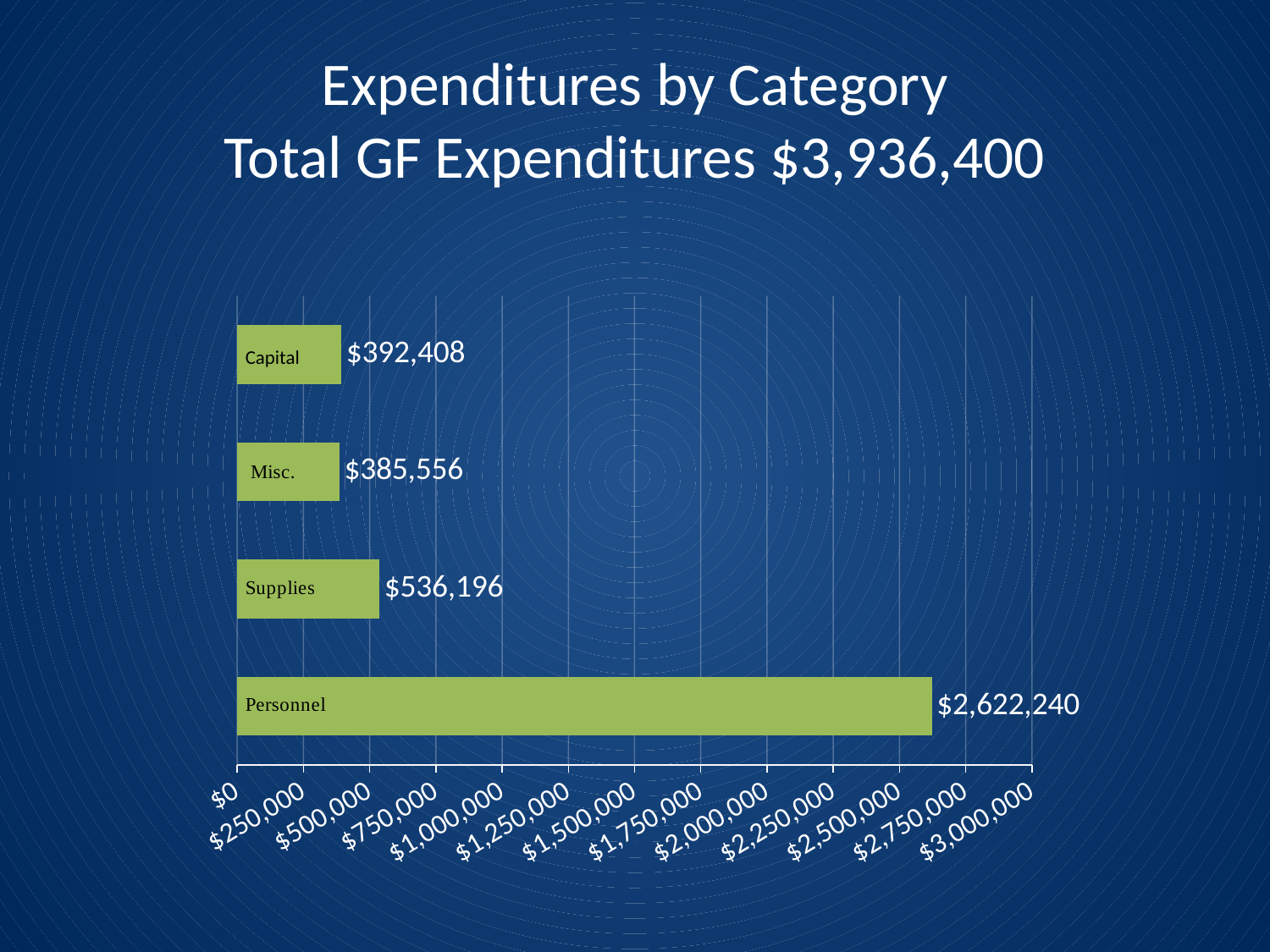
What total GF expenditures figure is stated in the chart title? $3,936,400 Which is larger, the value for Supplies or the value for Capital? Supplies What kind of chart is shown on the slide? Bar chart What is the value for Misc.? $385,556 What is the value for Capital? $392,408 What is the value for Personnel? $2,622,240 Which category has the highest expenditure? Personnel What is the difference between the Personnel and Supplies values? $2,086,044 Is the value for Personnel greater or less than $2,500,000? greater How many categories are shown in the chart? 4 What is the value for Supplies? $536,196 What is the difference between the Supplies and Capital values? $143,788